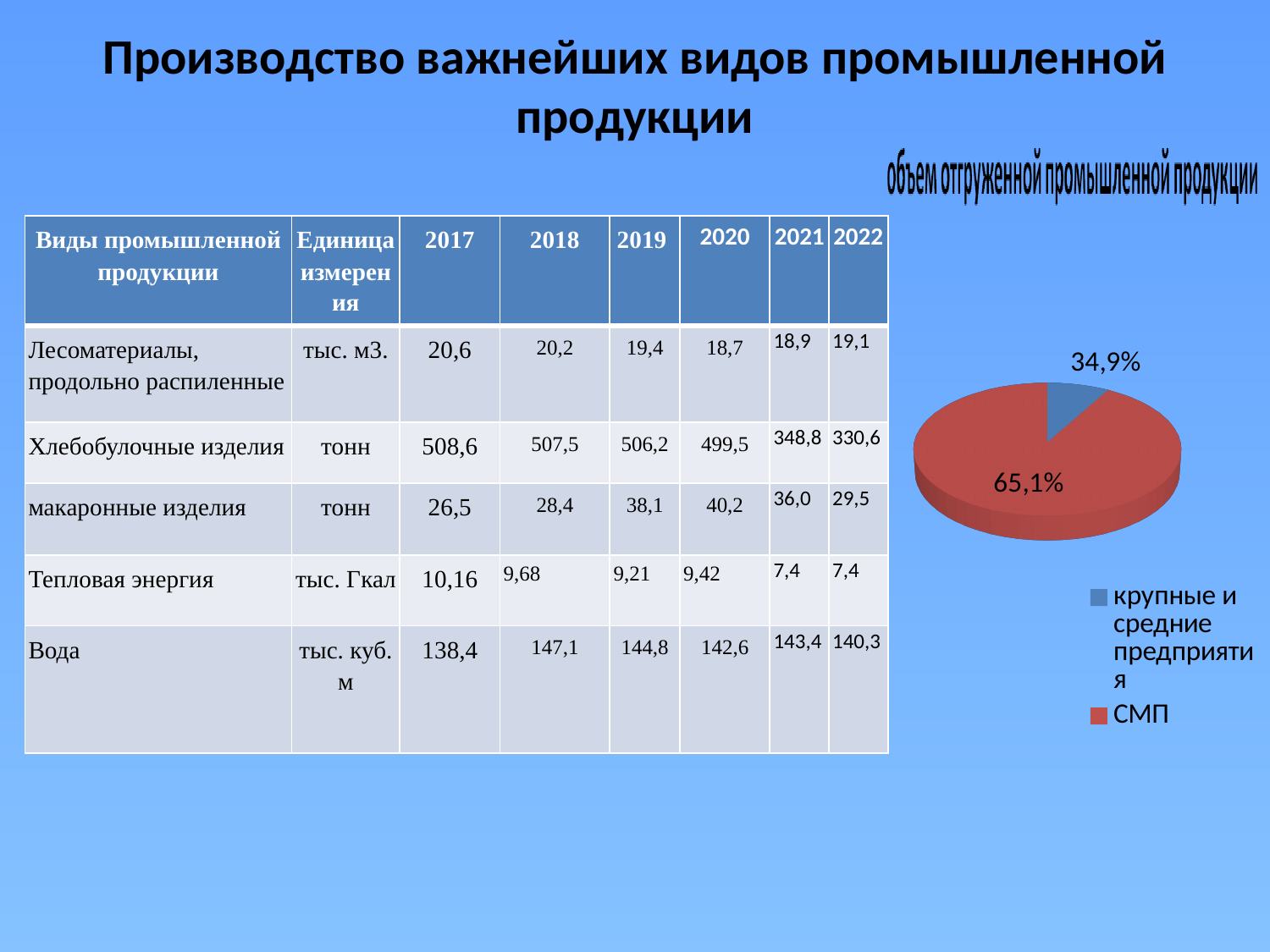
Which slice of the pie chart is the smallest? крупные и средние предприятия What is the difference in percentage points between the СМП slice and the крупные и средние предприятия slice in the pie chart? 30,2 What colour is the СМП slice in the pie chart? red In the pie chart, what share is shown for крупные и средние предприятия? 34,9% What is the title of the pie chart? объем отгруженной промышленной продукции How many entries does the pie chart's legend list? 2 How many slices does the pie chart have? 2 In the pie chart, what share is shown for СМП? 65,1% Which slice of the pie chart is the largest? СМП What kind of chart is shown on the right side of the slide? pie chart In the pie chart, which is larger: the share for СМП or the share for крупные и средние предприятия? СМП